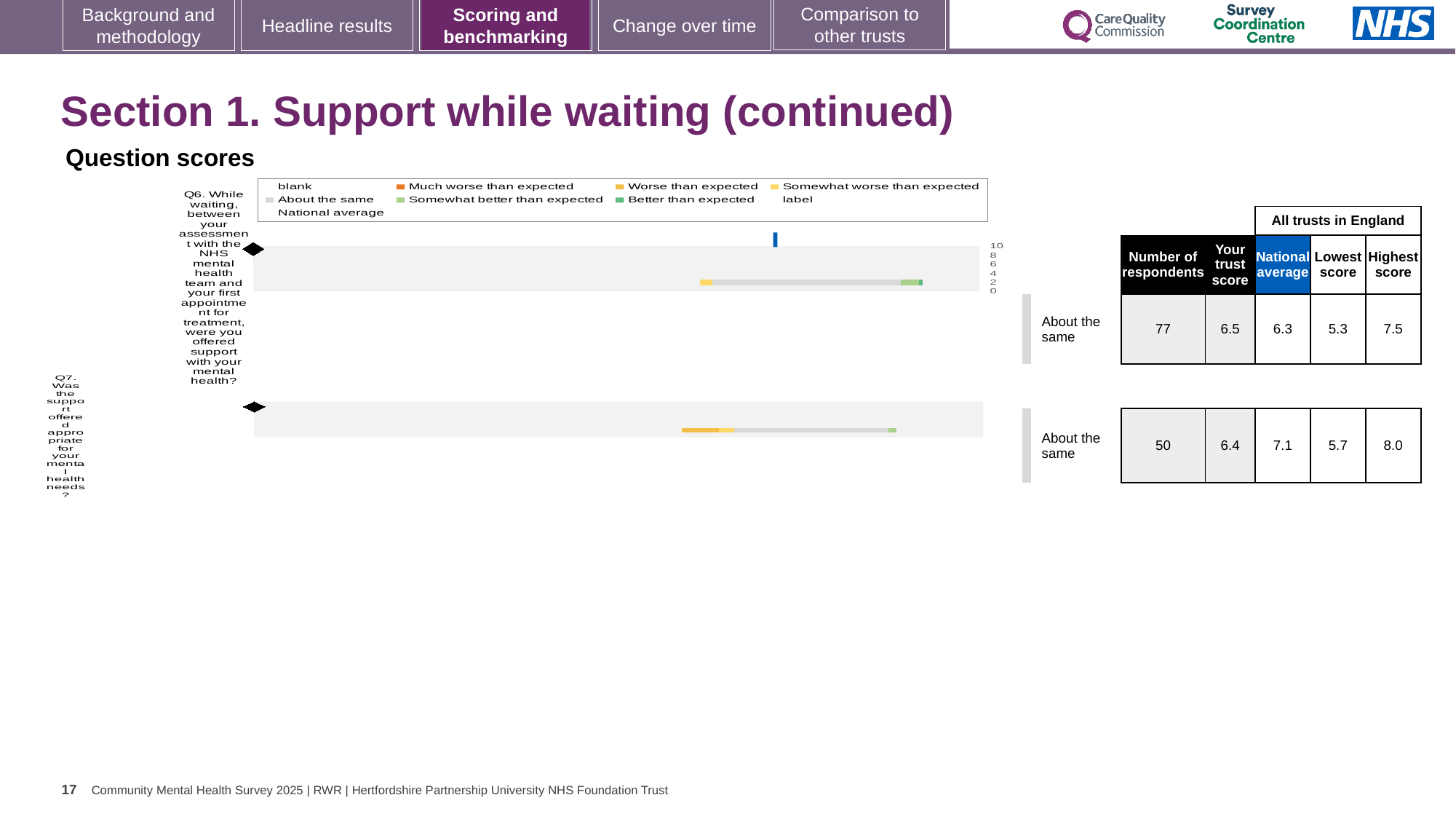
Which legend entry is shown in dark green? Better than expected What is the highest score among all trusts in England for Q7? 8.0 How many questions (bars) are plotted in the chart? 2 What is the national average score for Q6? 6.3 What is the national average score for Q7? 7.1 How many respondents answered Q7? 50 What is the difference between the highest and lowest scores for Q6? 2.2 What is the trust score for Q7 (was the support offered appropriate)? 6.4 What is the trust score for Q6 (support with mental health while waiting)? 6.5 What kind of chart is shown under 'Question scores'? bar chart Which question has the higher trust score, Q6 or Q7? Q6 What benchmark category is shown for both Q6 and Q7? About the same